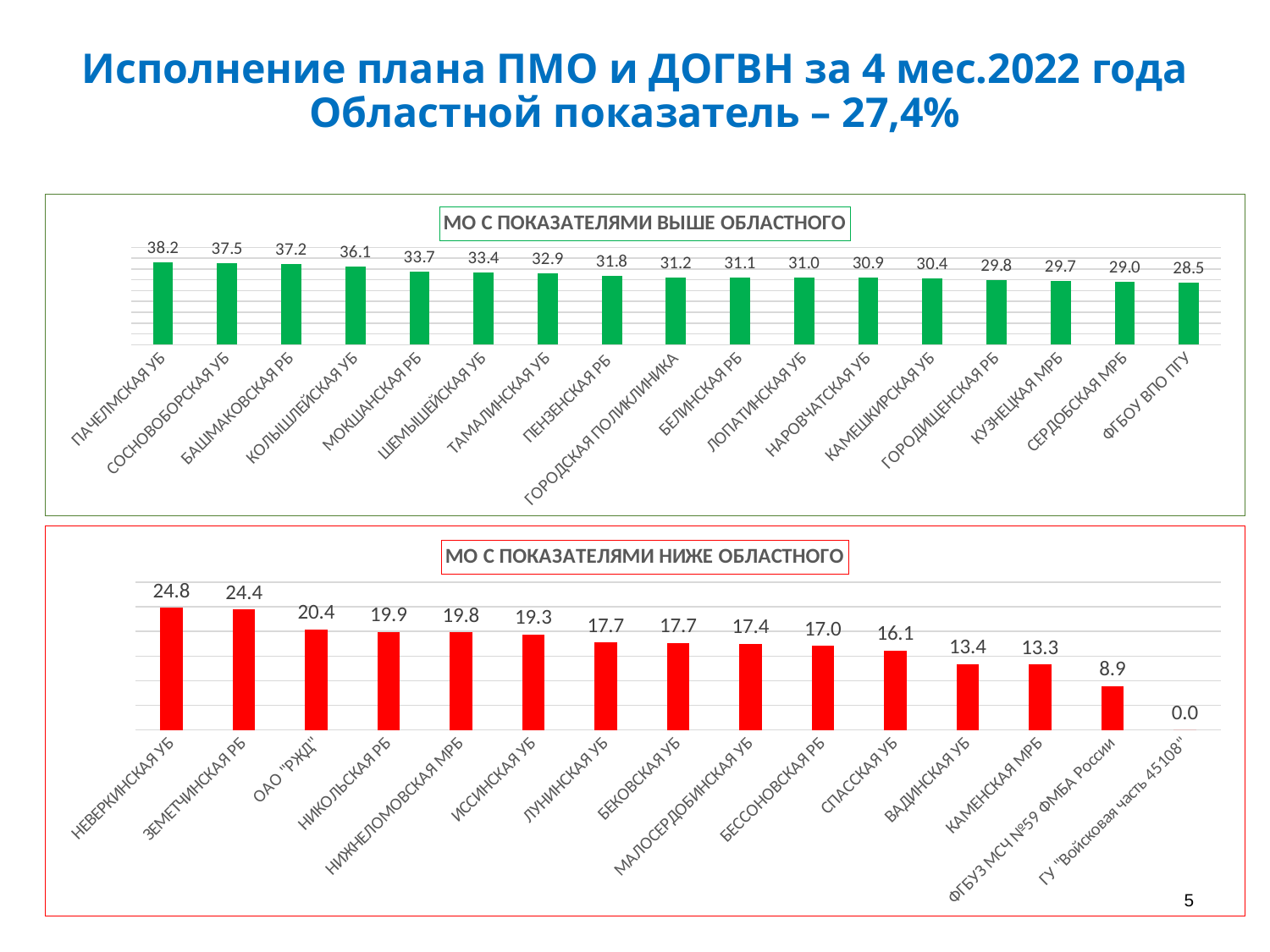
In the top chart (МО С ПОКАЗАТЕЛЯМИ ВЫШЕ ОБЛАСТНОГО), how many organisations are shown? 17 In the top chart (МО С ПОКАЗАТЕЛЯМИ ВЫШЕ ОБЛАСТНОГО), what is the value for ГОРОДСКАЯ ПОЛИКЛИНИКА? 31.2 What type of chart is used in the bottom chart (МО С ПОКАЗАТЕЛЯМИ НИЖЕ ОБЛАСТНОГО)? bar chart In the top chart (МО С ПОКАЗАТЕЛЯМИ ВЫШЕ ОБЛАСТНОГО), what is the difference between ПАЧЕЛМСКАЯ УБ and СОСНОВОБОРСКАЯ УБ? 0.7 In the bottom chart (МО С ПОКАЗАТЕЛЯМИ НИЖЕ ОБЛАСТНОГО), what is the value for ОАО "РЖД"? 20.4 In the bottom chart (МО С ПОКАЗАТЕЛЯМИ НИЖЕ ОБЛАСТНОГО), how many organisations are shown? 15 In the bottom chart (МО С ПОКАЗАТЕЛЯМИ НИЖЕ ОБЛАСТНОГО), what is the value for ГУ "Войсковая часть 45108"? 0.0 In the top chart (МО С ПОКАЗАТЕЛЯМИ ВЫШЕ ОБЛАСТНОГО), what is the value for ПАЧЕЛМСКАЯ УБ? 38.2 In the bottom chart (МО С ПОКАЗАТЕЛЯМИ НИЖЕ ОБЛАСТНОГО), which is larger: the value for СПАССКАЯ УБ or the value for ВАДИНСКАЯ УБ? СПАССКАЯ УБ In the top chart (МО С ПОКАЗАТЕЛЯМИ ВЫШЕ ОБЛАСТНОГО), which organisation has the lowest value? ФГБОУ ВПО ПГУ In the bottom chart (МО С ПОКАЗАТЕЛЯМИ НИЖЕ ОБЛАСТНОГО), which organisation has the highest value? НЕВЕРКИНСКАЯ УБ In the top chart (МО С ПОКАЗАТЕЛЯМИ ВЫШЕ ОБЛАСТНОГО), do the values rise or fall from left to right? fall